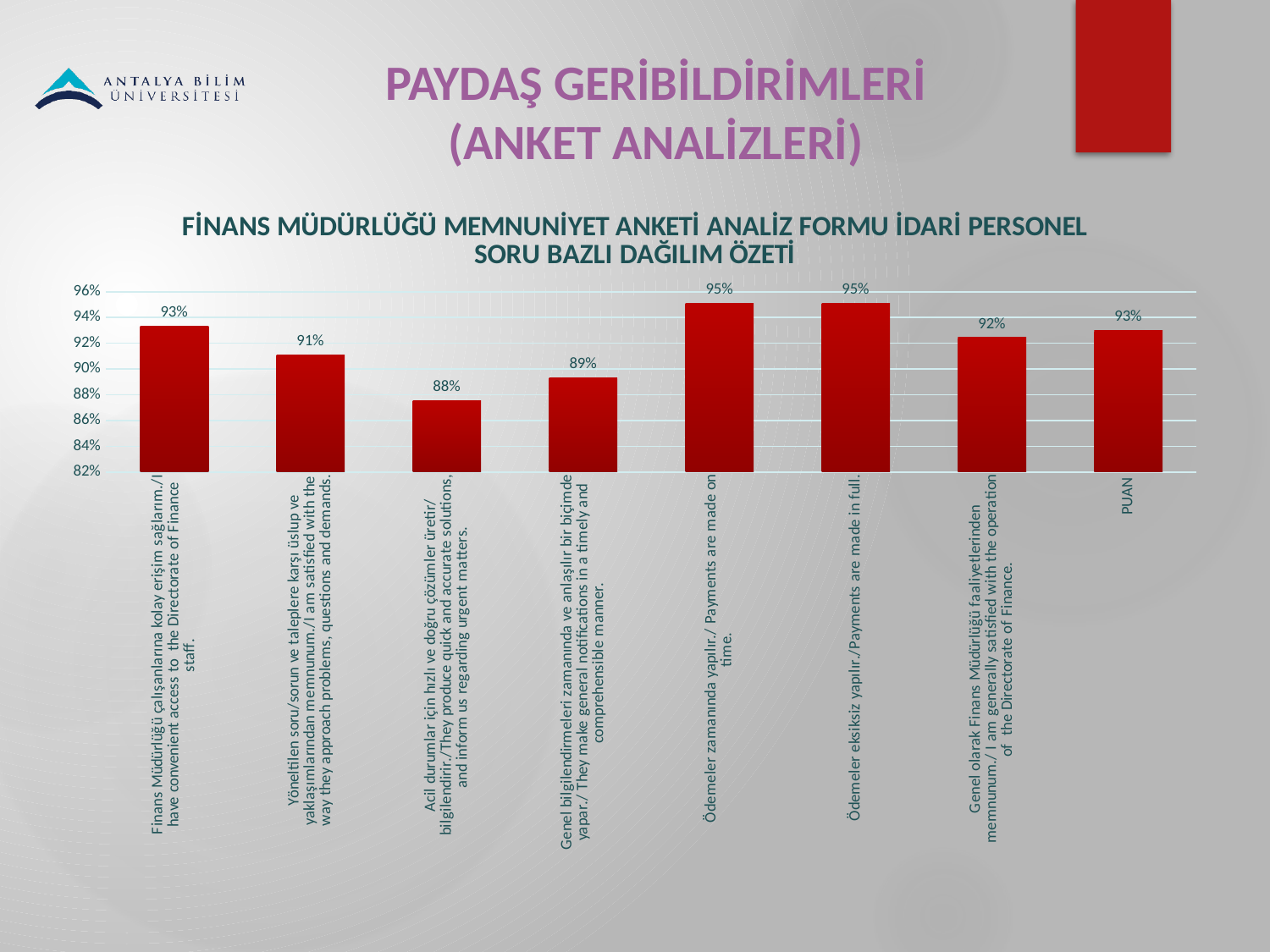
Which category has the lowest value? Acil durumlar için hızlı ve doğru çözümler üretir/ bilgilendirir. What is the value for PUAN? 93% What is the value for "Finans Müdürlüğü çalışanlarına kolay erişim sağlarım."? 93% What kind of chart is shown on the slide? bar chart What is the title of the chart? FİNANS MÜDÜRLÜĞÜ MEMNUNİYET ANKETİ ANALİZ FORMU İDARİ PERSONEL SORU BAZLI DAĞILIM ÖZETİ What is the difference between the value for "Ödemeler eksiksiz yapılır./Payments are made in full." and the value for "Acil durumlar için hızlı ve doğru çözümler üretir/ bilgilendirir."? 7% How many bars are shown in the chart? 8 Is the value for "Genel bilgilendirmeleri zamanında ve anlaşılır bir biçimde yapar." greater or less than 90%? less What is the value for "Ödemeler zamanında yapılır./ Payments are made on time."? 95% What is the value for "Acil durumlar için hızlı ve doğru çözümler üretir/ bilgilendirir."? 88% Which is larger: the value for "Yöneltilen soru/sorun ve taleplere karşı üslup ve yaklaşımlarından memnunum." or the value for "Genel bilgilendirmeleri zamanında ve anlaşılır bir biçimde yapar."? Yöneltilen soru/sorun ve taleplere karşı üslup ve yaklaşımlarından memnunum. What is the value for "Genel olarak Finans Müdürlüğü faaliyetlerinden memnunum."? 92%